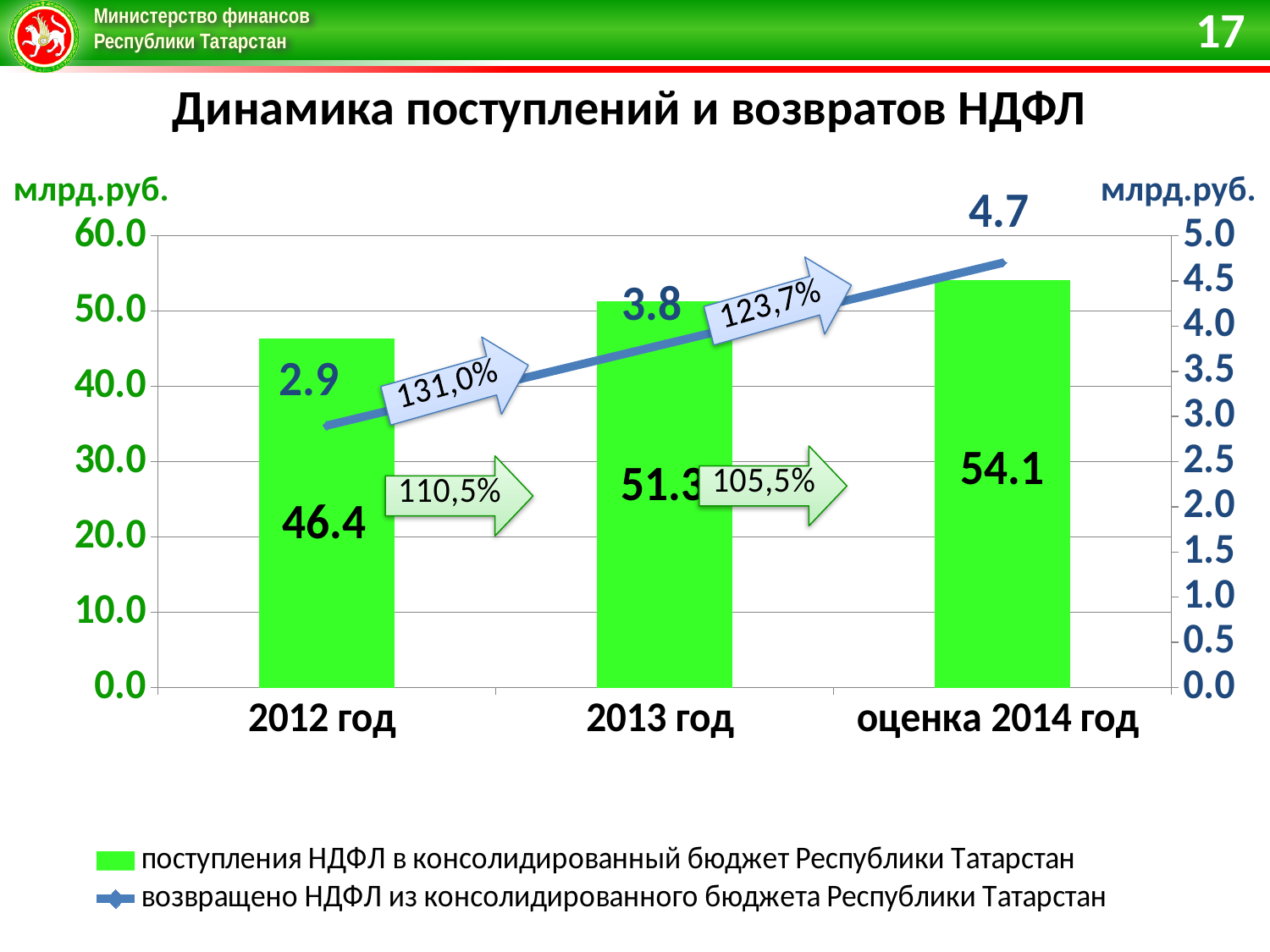
How many categories are shown on the x axis? 3 Do the values for поступления НДФЛ rise or fall from 2012 год to оценка 2014 год? rise Which category has the highest value for поступления НДФЛ в консолидированный бюджет Республики Татарстан? оценка 2014 год Which is larger: поступления НДФЛ for 2013 год or for оценка 2014 год? оценка 2014 год Which category has the lowest value for возвращено НДФЛ из консолидированного бюджета Республики Татарстан? 2012 год What is the value of поступления НДФЛ в консолидированный бюджет Республики Татарстан for 2012 год? 46.4 What is the value of поступления НДФЛ в консолидированный бюджет Республики Татарстан for оценка 2014 год? 54.1 What is the difference between the поступления НДФЛ values for 2013 год and 2012 год? 4.9 What is the value of возвращено НДФЛ из консолидированного бюджета Республики Татарстан for 2013 год? 3.8 What is the value of возвращено НДФЛ из консолидированного бюджета Республики Татарстан for 2012 год? 2.9 How many series does the legend list? 2 What is the difference between the возвращено НДФЛ values for оценка 2014 год and 2013 год? 0.9